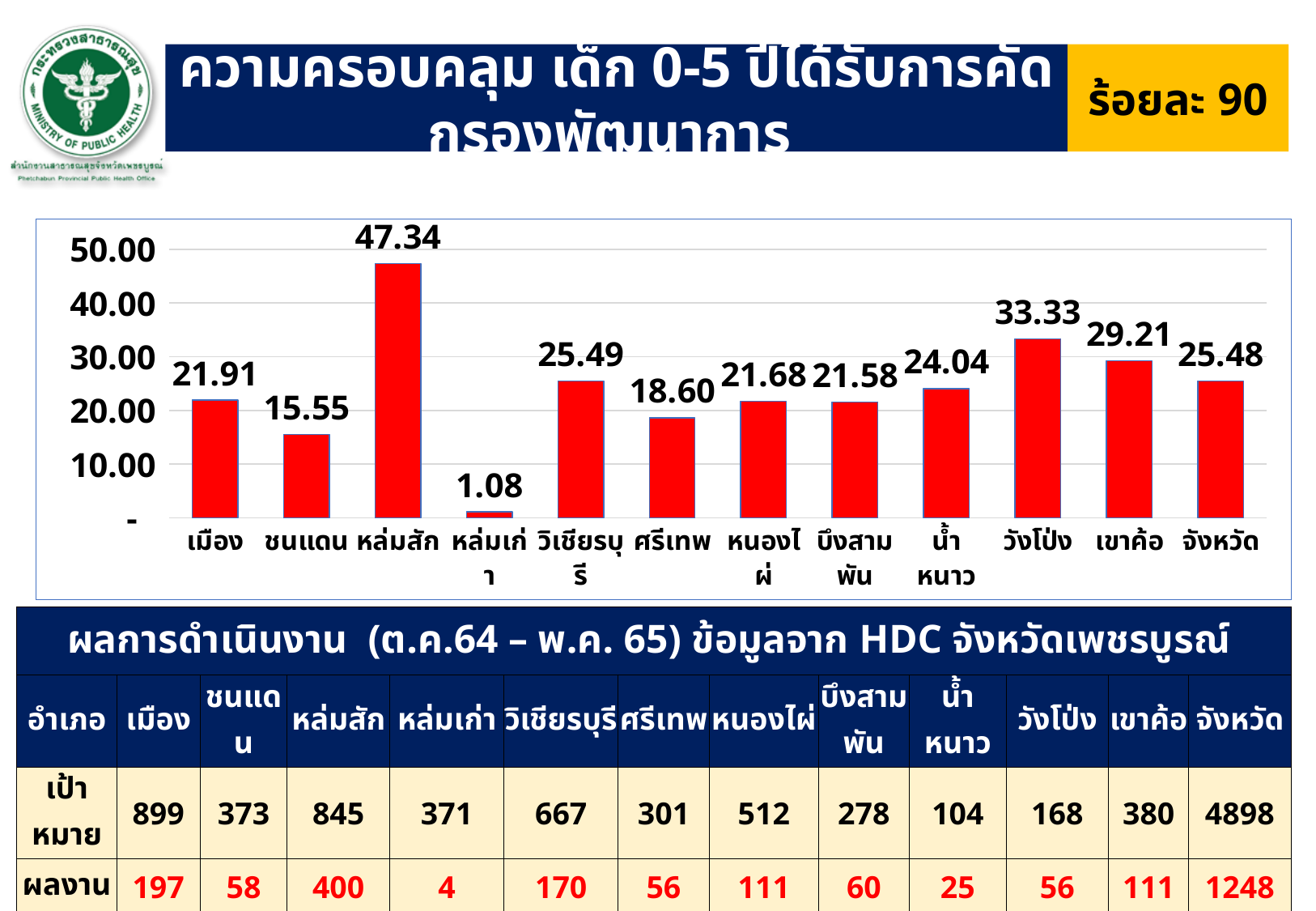
What is the value shown for วังโป่ง? 33.33 What colour are the bars in the chart? red Is the value for ชนแดน greater or less than 20.00? less How many bars (categories) are plotted in the chart? 12 What is the difference between the values for หล่มสัก and หล่มเก่า? 46.26 Which has a larger value, วิเชียรบุรี or ศรีเทพ? วิเชียรบุรี Which category has the highest value in the chart? หล่มสัก What type of chart is shown on the slide? bar chart Which category has the lowest value in the chart? หล่มเก่า What is the value shown for หล่มสัก? 47.34 What is the difference between the values for วังโป่ง and เขาค้อ? 4.12 What is the value shown for จังหวัด? 25.48